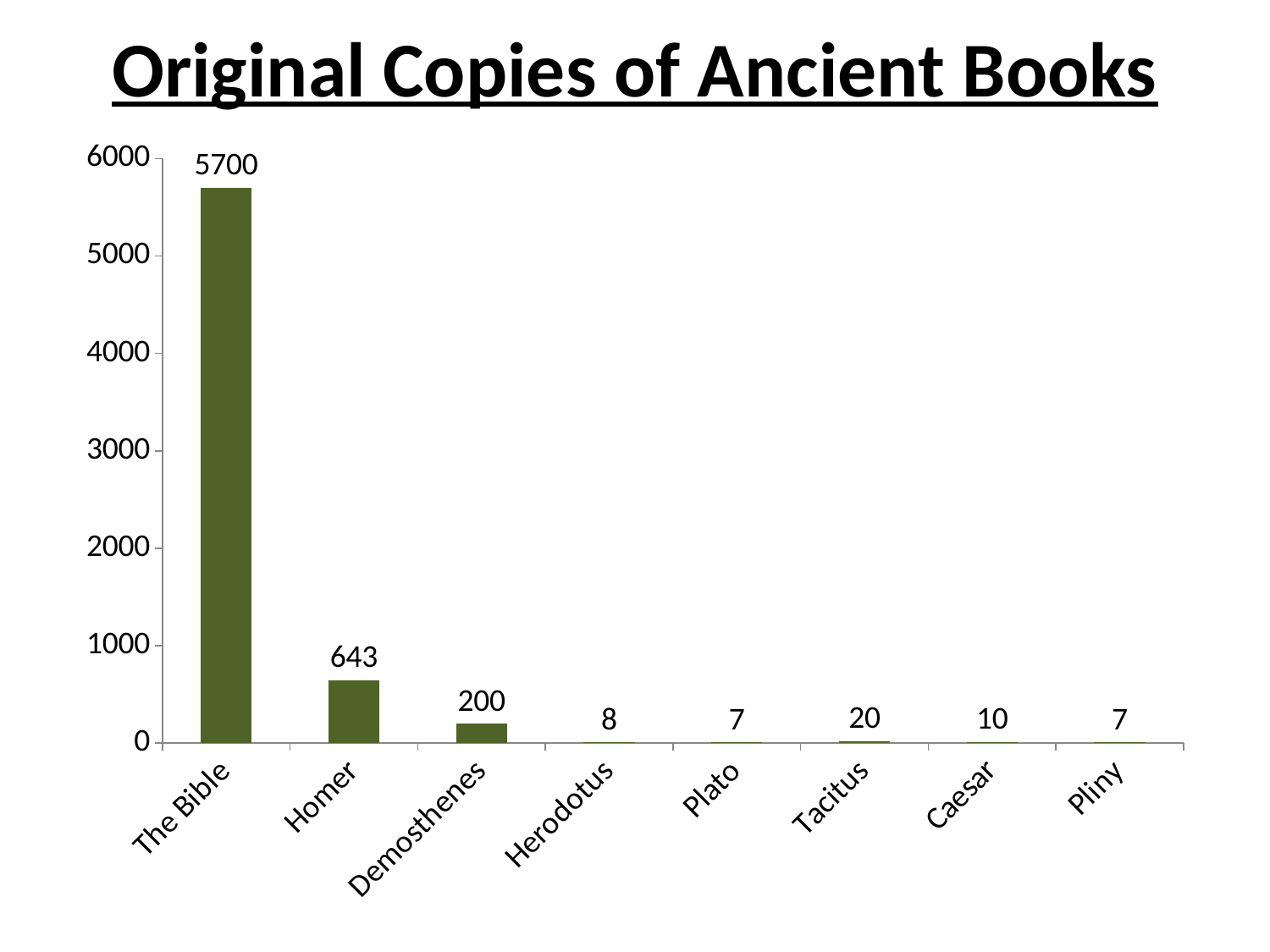
What is the value for Tacitus? 20 How many categories are shown on the x axis? 8 What is the value for Caesar? 10 Which is larger, the value for Herodotus or the value for Plato? Herodotus Which category has the highest value? The Bible What is the title of the chart? Original Copies of Ancient Books What kind of chart is this? Bar chart What is the difference between the values for Tacitus and Caesar? 10 What is the value for The Bible? 5700 What is the value for Demosthenes? 200 What is the difference between the values for The Bible and Homer? 5057 What is the value for Homer? 643